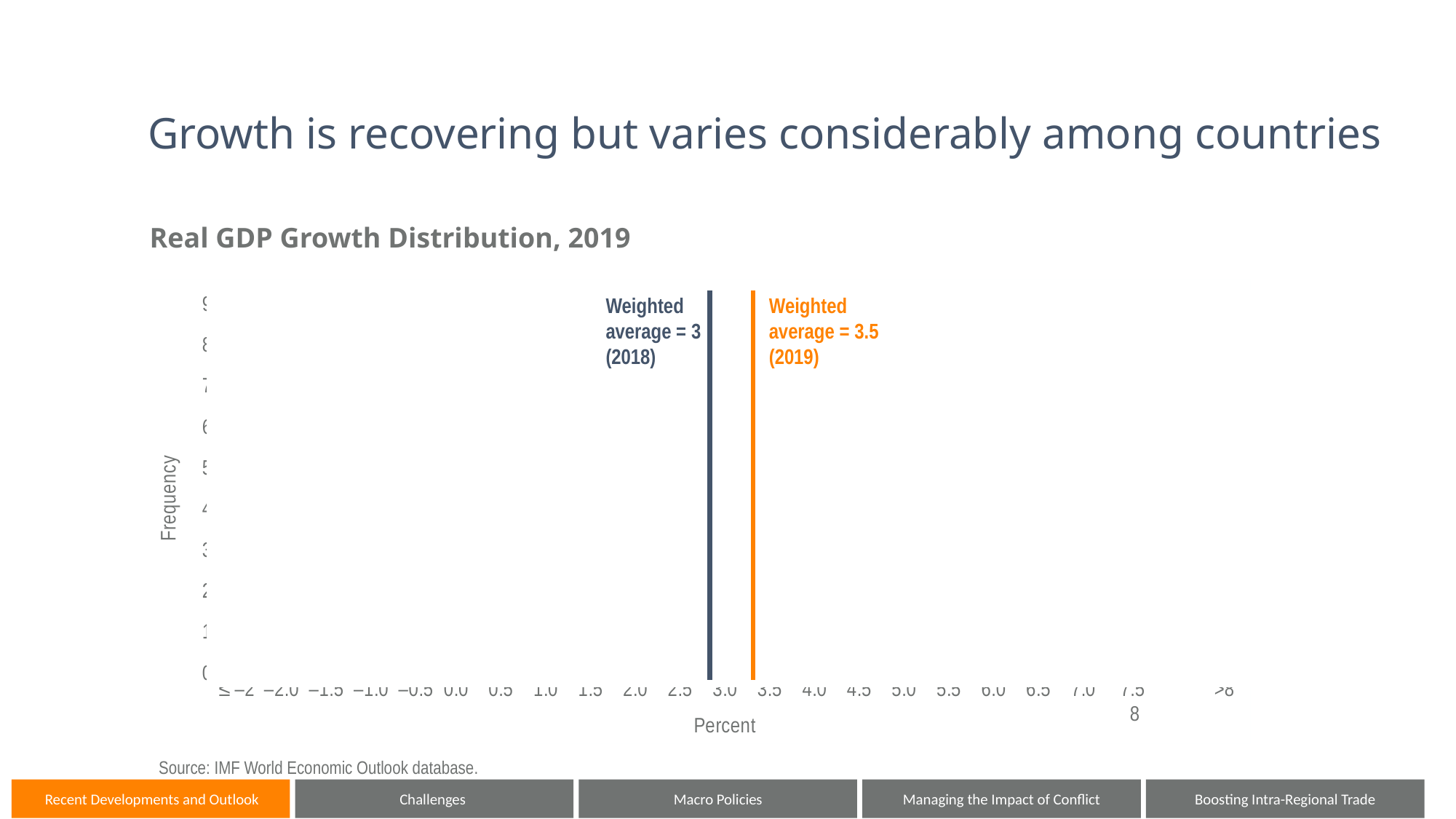
What is the weighted average real GDP growth for 2019 shown on the chart? 3.5 By how much did the weighted average growth rise from 2018 to 2019? 0.5 What is the source cited for the chart? IMF World Economic Outlook database What is the weighted average real GDP growth for 2018 shown on the chart? 3 What is the title of the chart? Real GDP Growth Distribution, 2019 Is the 2018 weighted average greater or less than 3.5 on the Percent axis? less What colour is the vertical line marking the 2019 weighted average? Orange What is the label on the horizontal axis of the chart? Percent Which year has the higher weighted average growth, 2018 or 2019? 2019 What is the label on the vertical axis of the chart? Frequency Is the 2019 weighted average greater or less than 3.0 on the Percent axis? greater